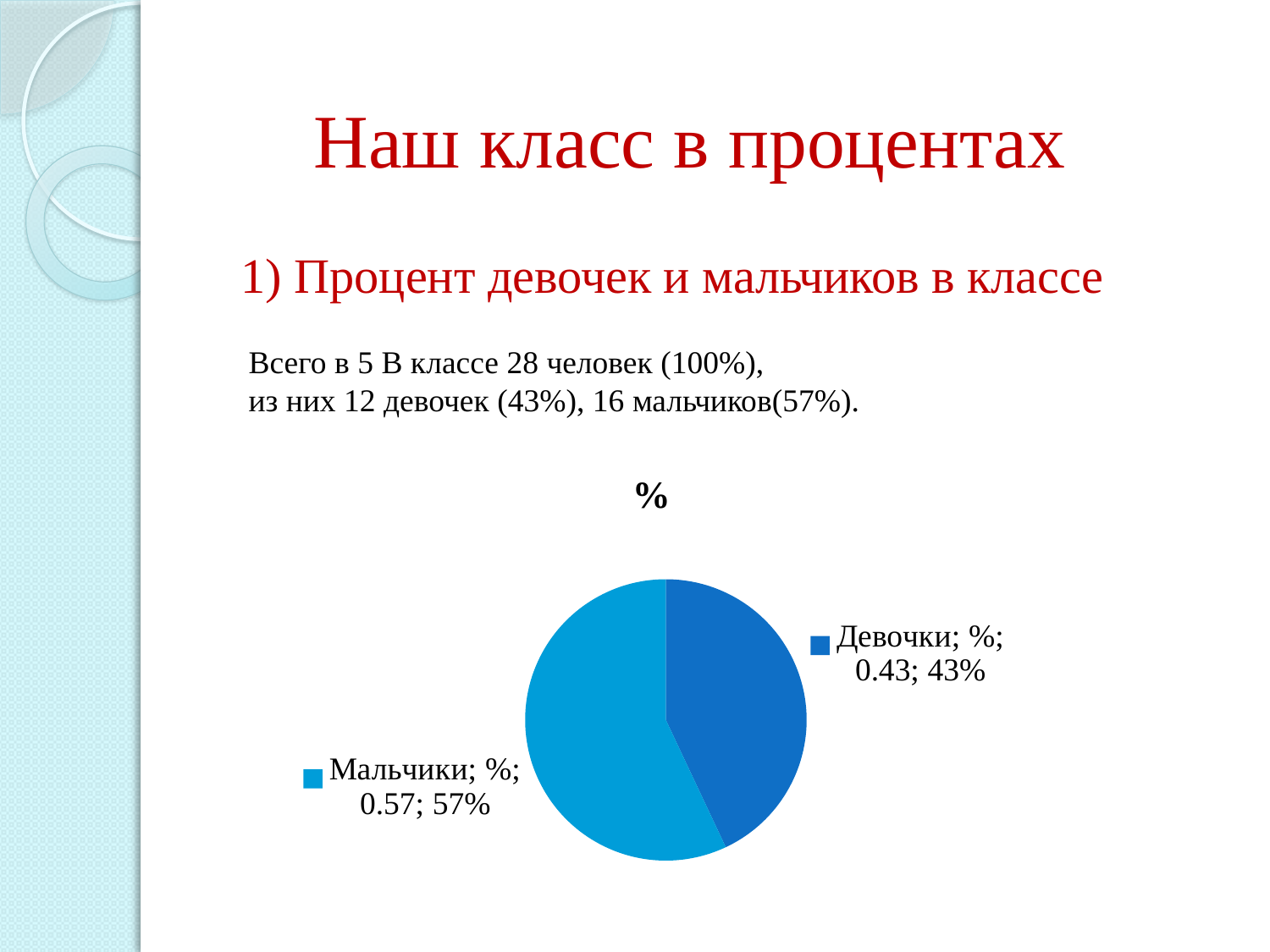
What is the difference in percentage points between the Мальчики and Девочки slices? 14% What kind of chart is shown on the slide? pie chart What is the chart's title? % How many slices does the pie chart have? 2 Which is larger, the Девочки slice or the Мальчики slice? Мальчики What share of the pie does the Девочки slice represent? 43% Which slice is drawn in the darker blue colour? Девочки Which slice is the smallest in the pie chart? Девочки Which slice is the largest in the pie chart? Мальчики What value is printed in the data label for Девочки? 0.43 What share of the pie does the Мальчики slice represent? 57% What value is printed in the data label for Мальчики? 0.57